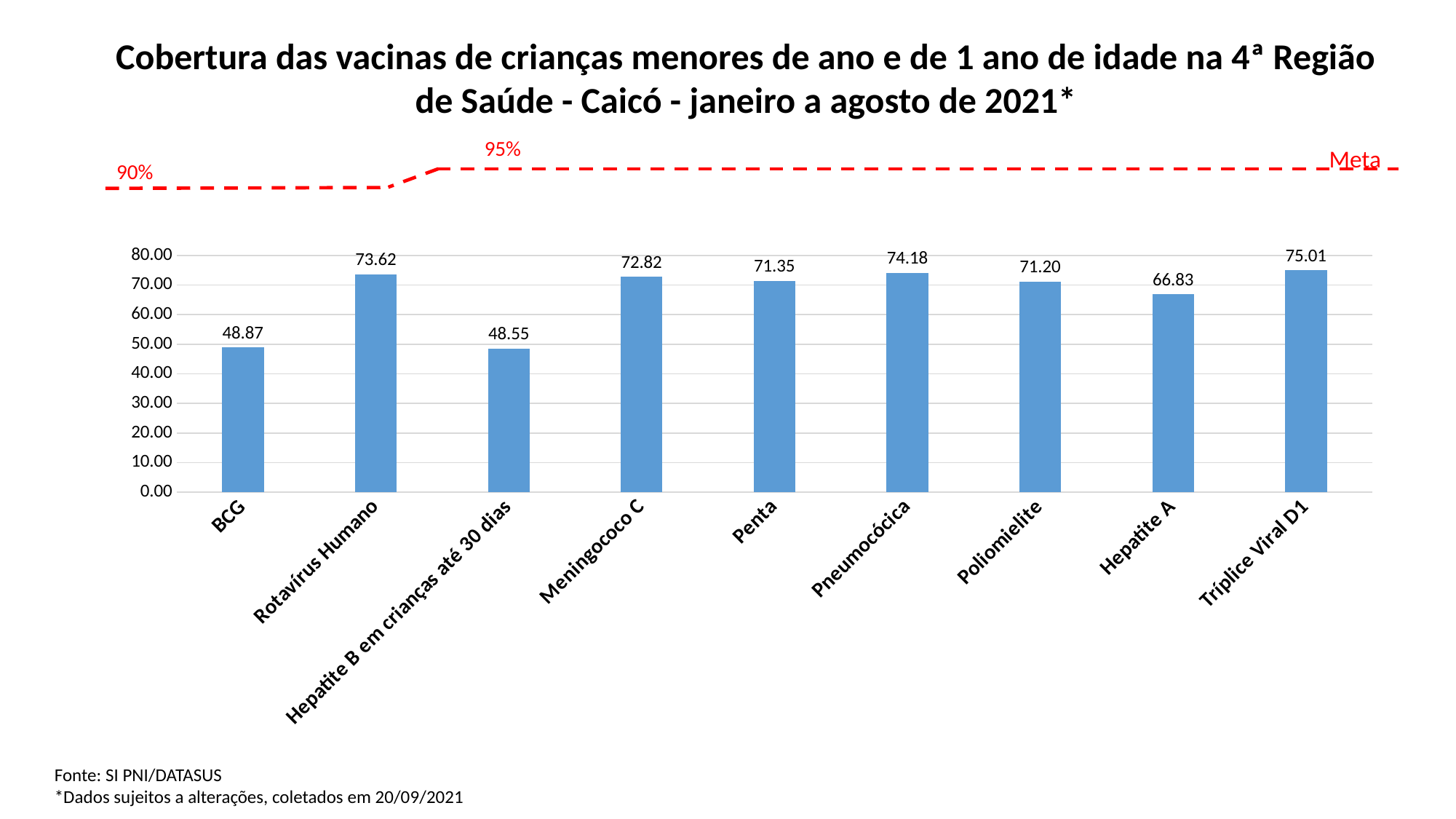
Which category has the highest value? Tríplice Viral D1 How many categories are shown on the x axis? 9 What is the difference between the values for Pneumocócica and Penta? 2.83 Is the value for Poliomielite greater or less than 70.00? greater Which category has the lowest value? Hepatite B em crianças até 30 dias What label is given to the red dashed line above the bars? Meta Which is larger, the value for Rotavírus Humano or the value for Meningococo C? Rotavírus Humano What is the value for BCG? 48.87 What is the difference between the values for BCG and Hepatite B em crianças até 30 dias? 0.32 What is the value for Hepatite A? 66.83 What is the value for Tríplice Viral D1? 75.01 What kind of chart is this? bar chart